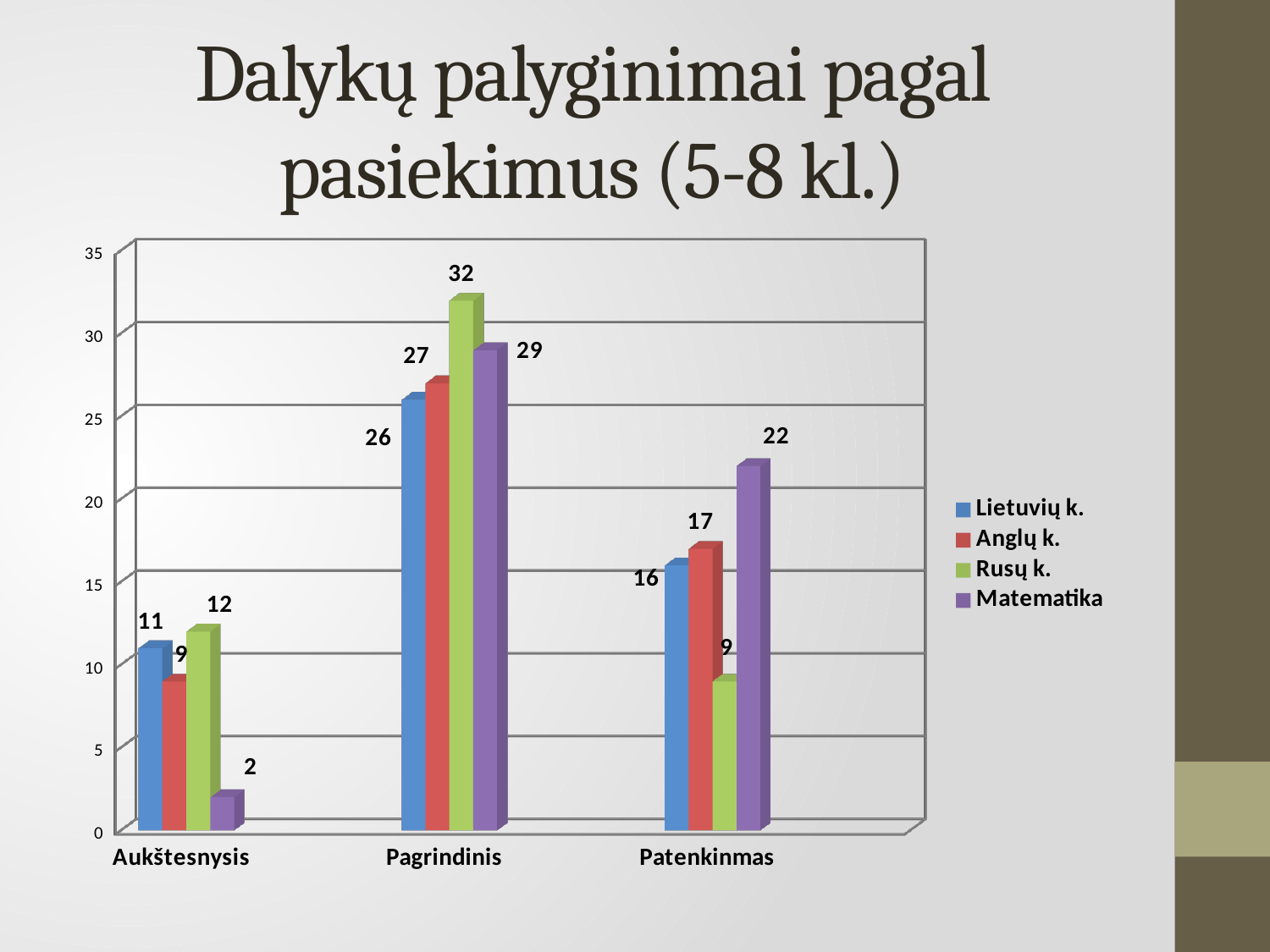
Which series has the lowest value in the Aukštesnysis category? Matematika What is the difference between Rusų k. and Lietuvių k. in the Pagrindinis category? 6 What is the title of the slide? Dalykų palyginimai pagal pasiekimus (5-8 kl.) What kind of chart is shown on the slide? Bar chart How many series does the legend list? 4 Which is larger in the Aukštesnysis category: Lietuvių k. or Rusų k.? Rusų k. Which series has the highest value in the Patenkinmas category? Matematika What is the total of the four series values in the Aukštesnysis category? 34 What is the value for Rusų k. in the Pagrindinis category? 32 How many categories are shown on the x axis? 3 What is the value for Matematika in the Aukštesnysis category? 2 What is the value for Anglų k. in the Patenkinmas category? 17